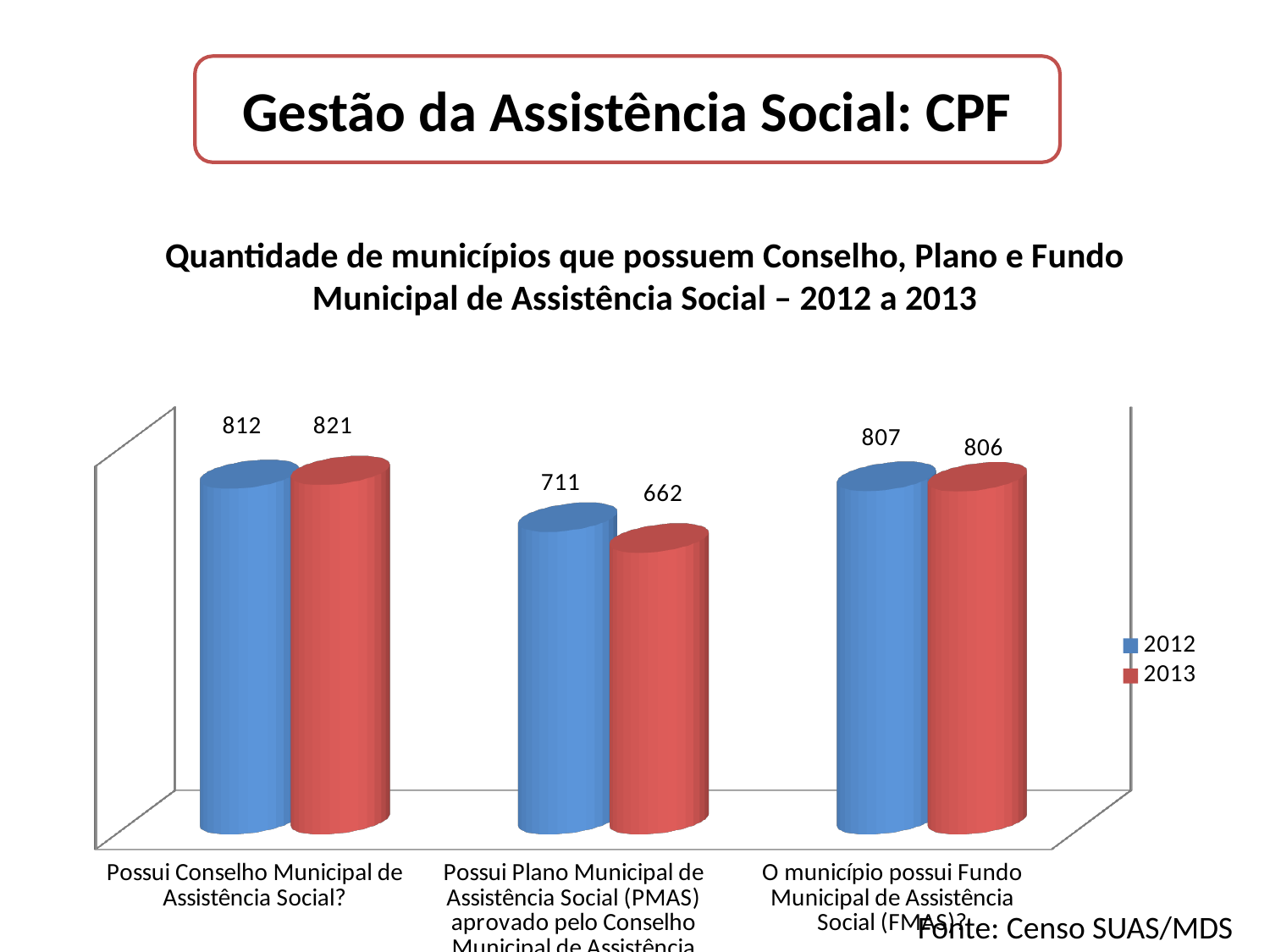
Which colour represents the 2013 series in the legend? red What is the 2012 value for the category about the Fundo Municipal de Assistência Social (FMAS)? 807 How many categories are shown on the x axis? 3 How many series does the legend list? 2 What is the 2012 value for the category about the Plano Municipal de Assistência Social (PMAS)? 711 What is the 2013 value for the category about the Plano Municipal de Assistência Social (PMAS)? 662 What is the 2013 value for 'Possui Conselho Municipal de Assistência Social?'? 821 What kind of chart is shown on the slide? bar chart What is the difference between the 2012 and 2013 values for the Plano Municipal de Assistência Social (PMAS) category? 49 Which category has the lowest 2013 value? Possui Plano Municipal de Assistência Social (PMAS) For the Conselho Municipal de Assistência Social category, which year has the larger value, 2012 or 2013? 2013 What is the 2012 value for 'Possui Conselho Municipal de Assistência Social?'? 812